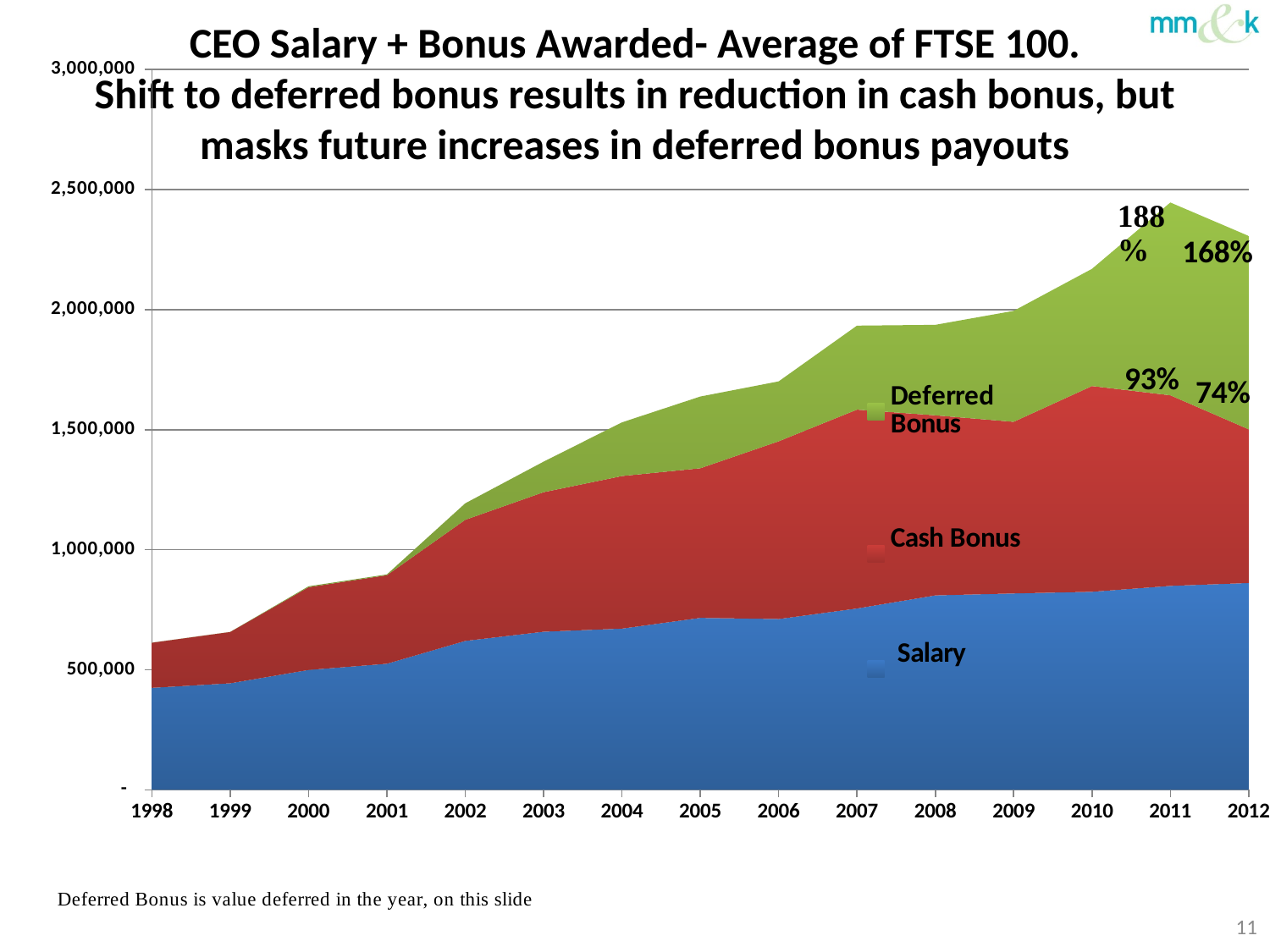
How many series does the chart's legend list? 3 Is the Salary value in 1998 greater or less than 500,000? less Does the total of salary plus bonuses generally rise or fall from 1998 to 2011? rise Is the total of salary plus bonuses in 2012 greater or less than 2,000,000? greater In which year is the total of salary plus bonuses highest? 2011 How many years are plotted along the x axis? 15 Is the total of salary plus bonuses in 2001 greater or less than 1,000,000? less In which year is the total of salary plus bonuses lowest? 1998 Which series is plotted at the bottom of the stacked area chart? Salary What is the title of the chart? CEO Salary + Bonus Awarded- Average of FTSE 100. What kind of chart is shown on the slide? Stacked area chart Which year has the larger total of salary plus bonuses, 2011 or 2012? 2011